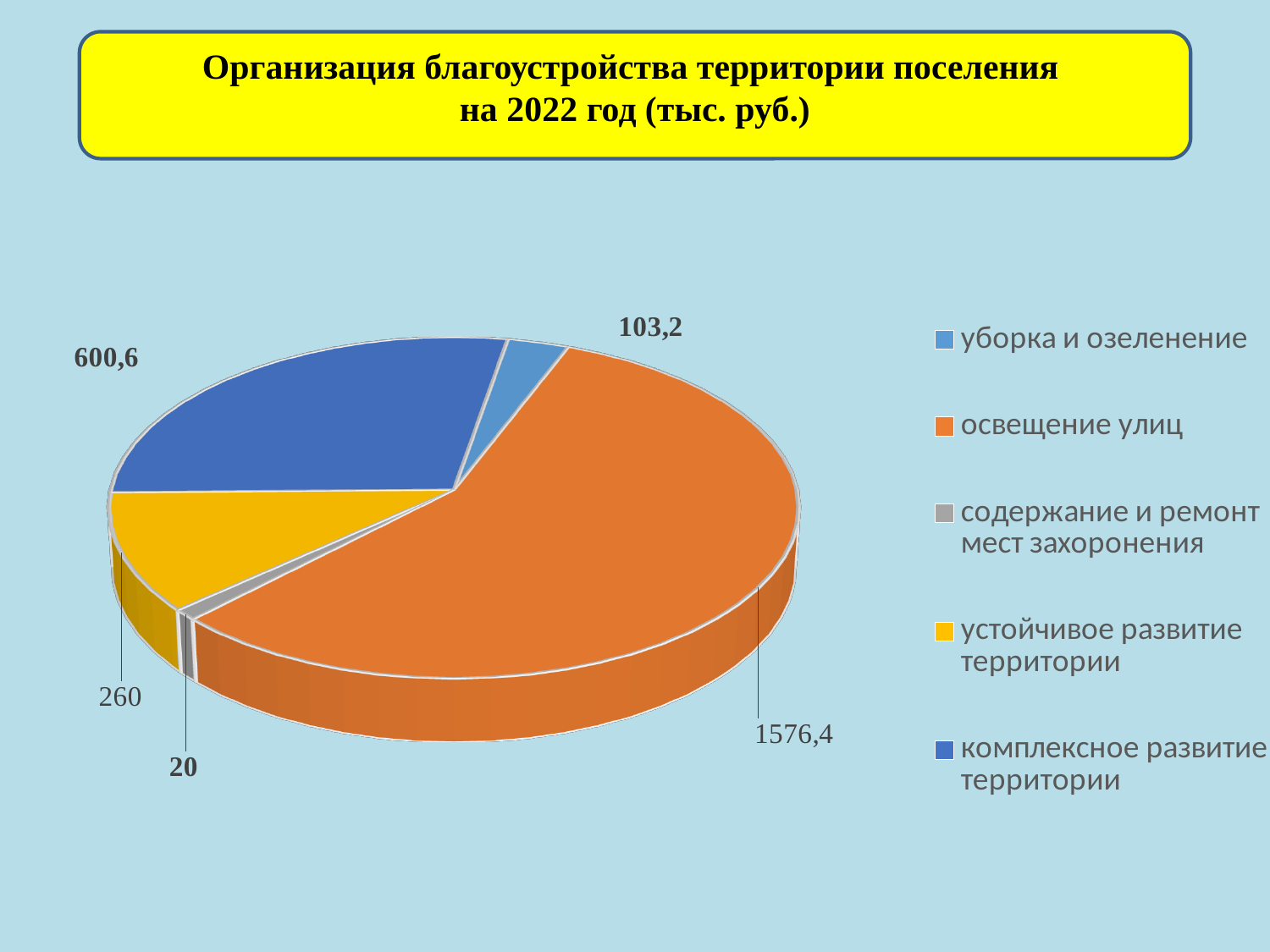
Which is larger: the value for комплексное развитие территории or the value for устойчивое развитие территории? комплексное развитие территории How many categories does the pie chart show? 5 What value is shown for устойчивое развитие территории? 260 What type of chart is shown on the slide? pie chart What value is shown for комплексное развитие территории? 600,6 What value is shown for уборка и озеленение? 103,2 What value is shown for освещение улиц? 1576,4 Which category has the largest slice of the pie? освещение улиц What is the difference between the values for освещение улиц and комплексное развитие территории? 975,8 Which category has the smallest slice of the pie? содержание и ремонт мест захоронения What value is shown for содержание и ремонт мест захоронения? 20 What is the difference between the values for устойчивое развитие территории and содержание и ремонт мест захоронения? 240